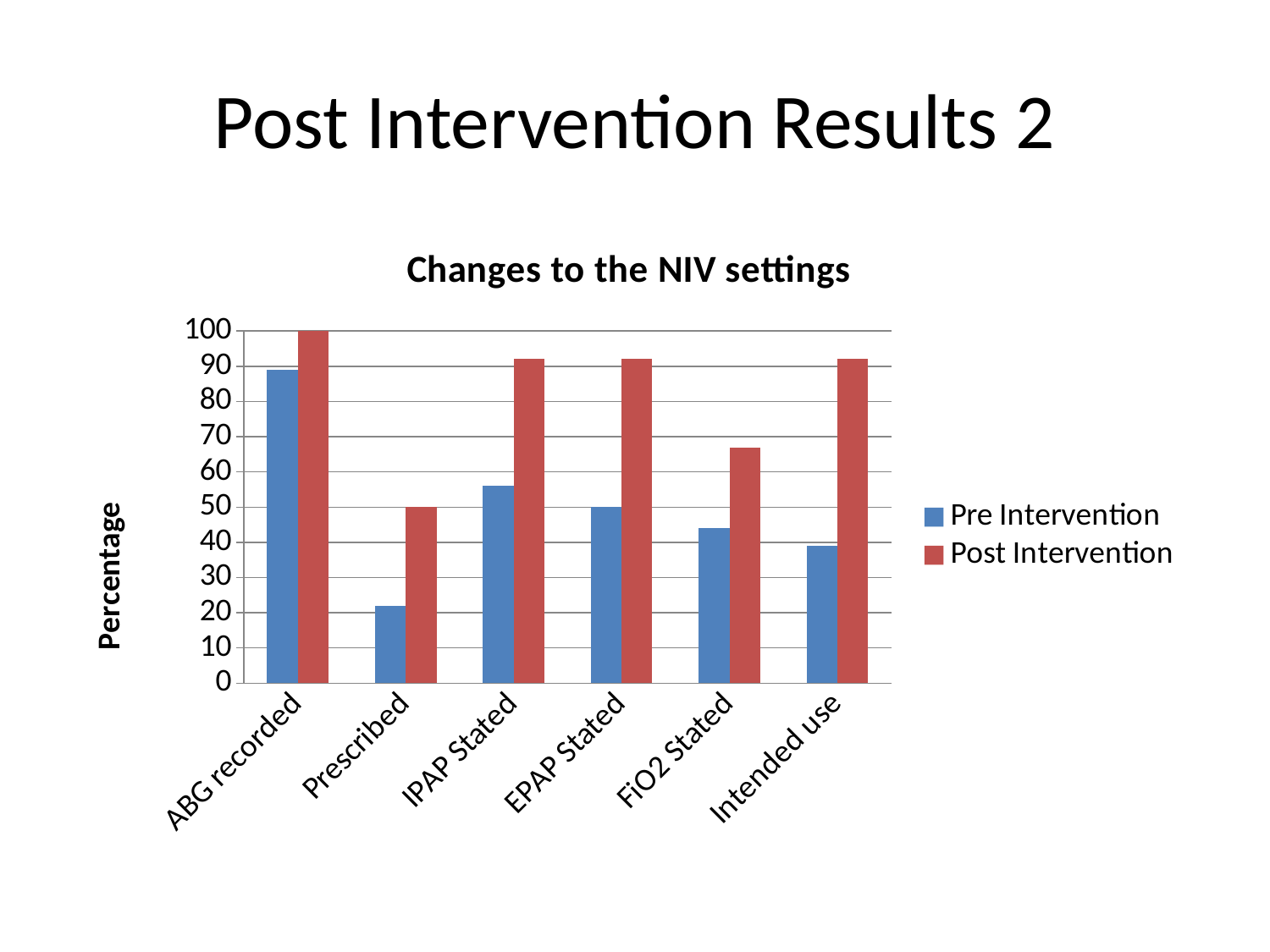
Is the Pre Intervention value for ABG recorded greater or less than 80? greater What is the title of the chart? Changes to the NIV settings How many series does the legend list? 2 What is the Post Intervention value for ABG recorded? 100 What type of chart is shown on the slide? bar chart How many categories are shown on the x axis? 6 Which category has the highest Post Intervention value? ABG recorded Which is larger for Intended use: the Pre Intervention value or the Post Intervention value? Post Intervention Which category has the lowest Pre Intervention value? Prescribed What is the label of the y axis? Percentage Is the Post Intervention value for FiO2 Stated greater or less than 70? less What is the Post Intervention value for Prescribed? 50